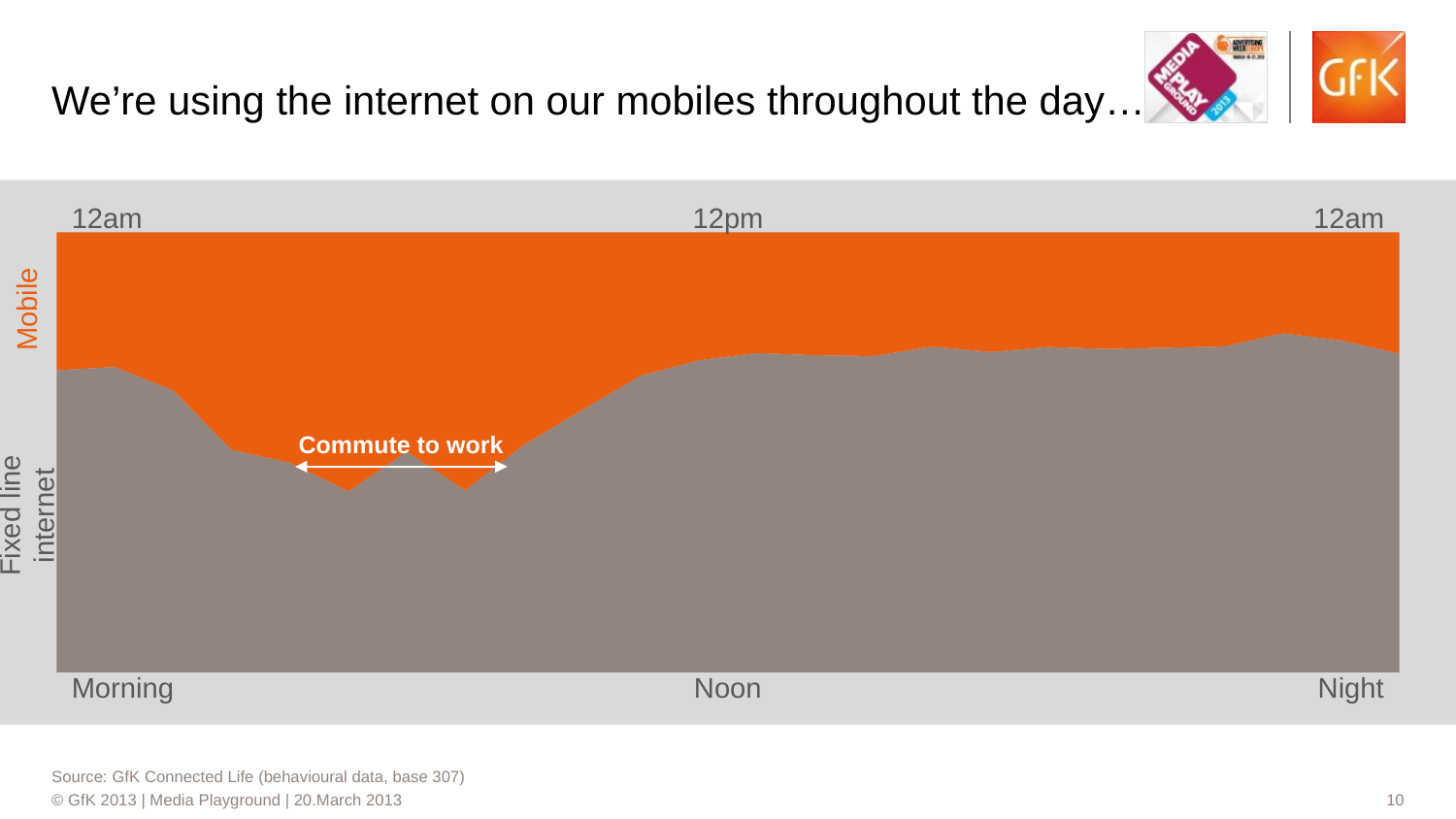
What is the title of the slide? We're using the internet on our mobiles throughout the day… What kind of chart is shown on the slide? Stacked area chart What time label appears at the middle of the x axis? 12pm What colour represents Mobile in the chart? Orange Does the Fixed line internet share rise or fall from the commute-to-work period towards noon? Rise Is the Mobile share of the chart larger during the commute to work or at noon? During the commute to work Which series occupies the larger share of the chart at noon? Fixed line internet How many series does the chart show? 2 Does the Mobile share rise or fall from 12am in the morning to the commute-to-work period? Rise